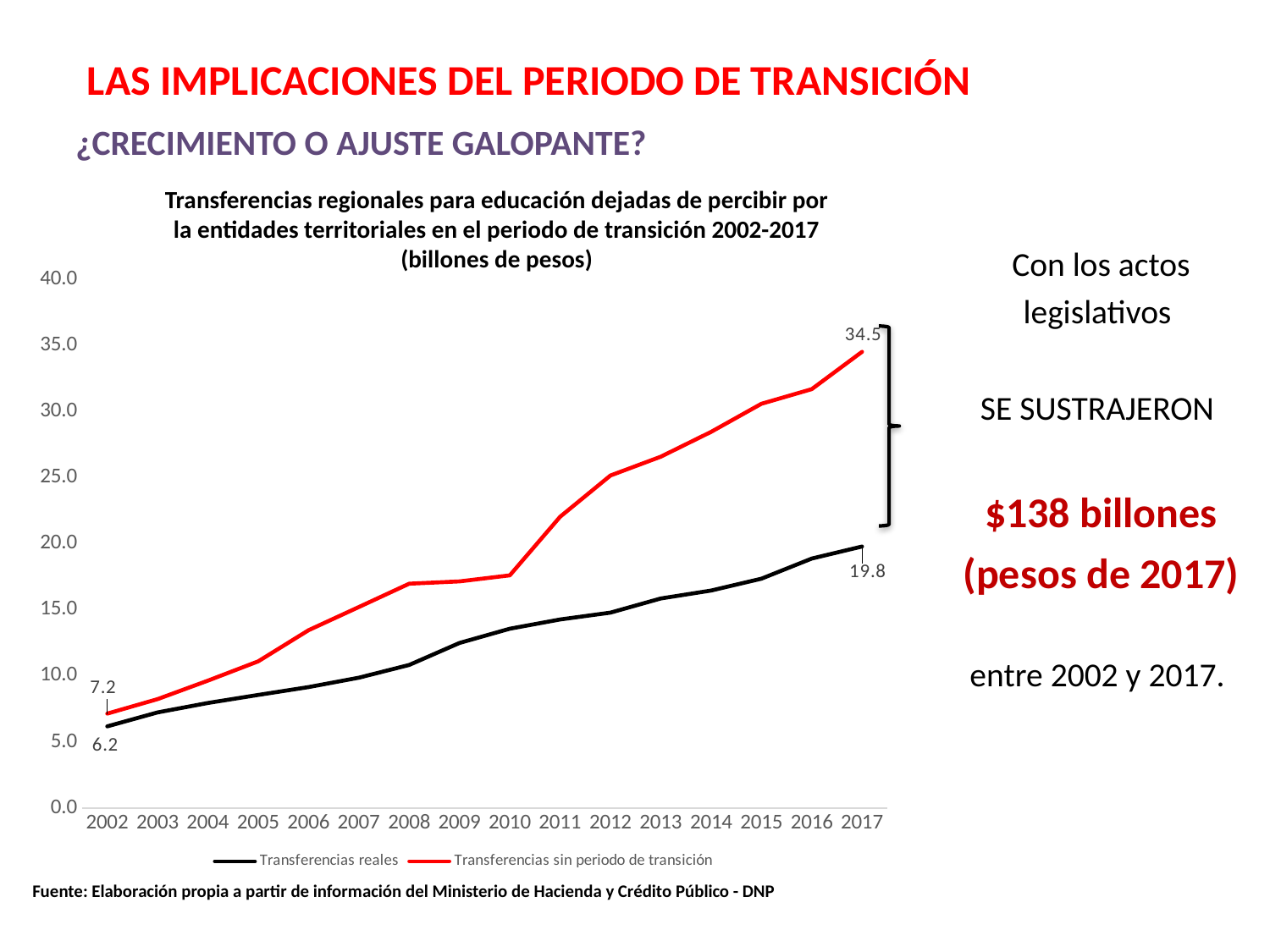
What is the value of Transferencias reales in 2017? 19.8 What is the difference between Transferencias sin periodo de transición and Transferencias reales in 2017? 14.7 How many years are plotted on the x axis? 16 What is the value of Transferencias sin periodo de transición in 2002? 7.2 What is the value of Transferencias reales in 2002? 6.2 Do the values of Transferencias sin periodo de transición rise or fall from 2002 to 2017? rise Is the value of Transferencias reales in 2010 greater or less than 15.0? less What is the value of Transferencias sin periodo de transición in 2017? 34.5 Which series has the higher value in 2017, Transferencias reales or Transferencias sin periodo de transición? Transferencias sin periodo de transición What type of chart is shown on the slide? line chart How many series does the legend list? 2 What colour is the line for Transferencias sin periodo de transición? red